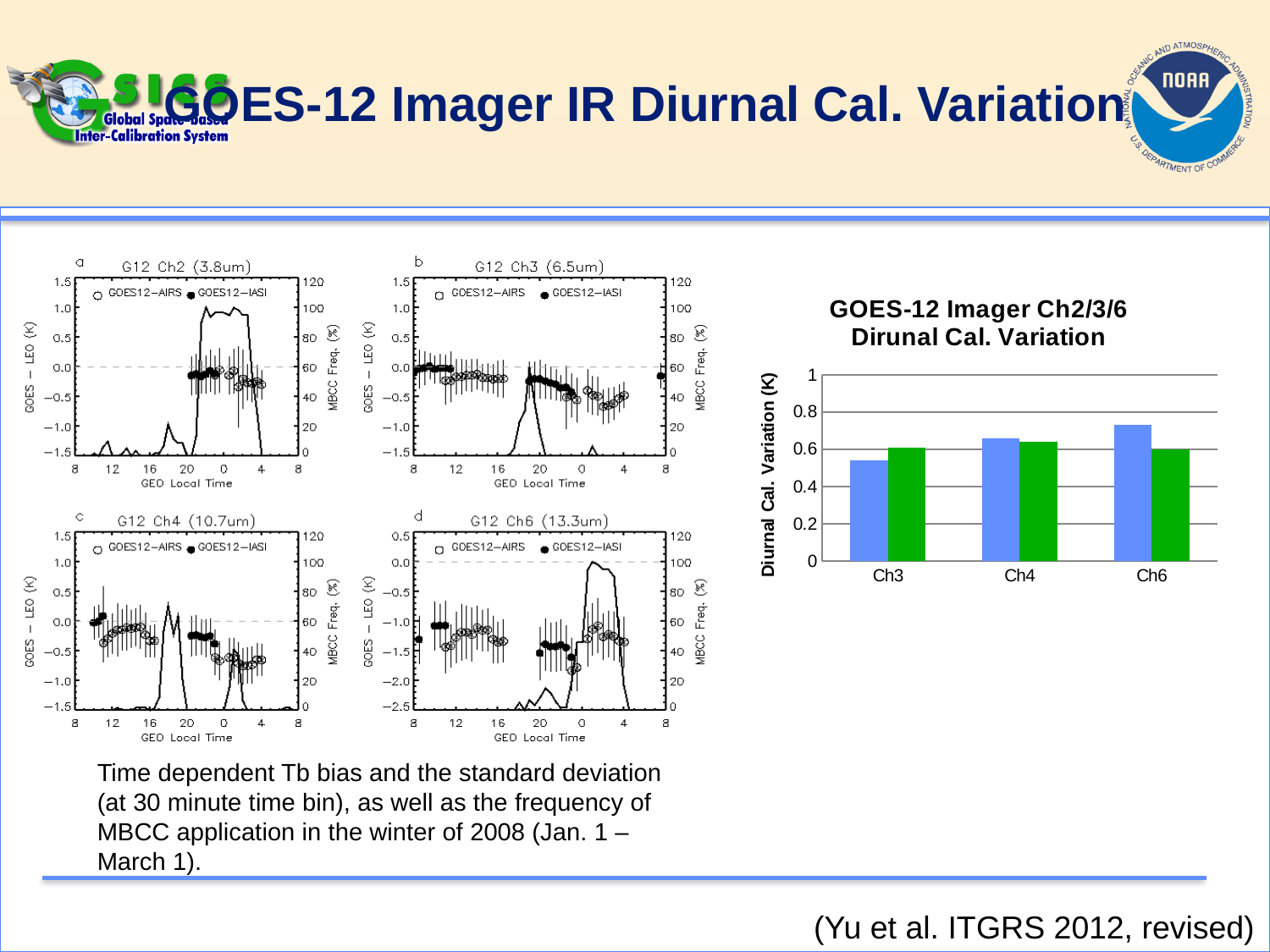
In the bar chart on the right, do the blue bars rise or fall from Ch3 to Ch6? rise In the bar chart on the right, is the blue bar for Ch6 greater or less than 0.6? greater What kind of chart is the 'GOES-12 Imager Ch2/3/6 Dirunal Cal. Variation' chart on the right of the slide? bar chart In the bar chart on the right, for Ch3, is the blue bar or the green bar taller? green In the bar chart on the right, is the blue bar for Ch3 greater or less than 0.6? less In the bar chart on the right, which channel has the tallest blue bar? Ch6 In the four-panel figure on the left, what wavelength is given in the title of the G12 Ch4 panel? 10.7um How many channel categories are shown on the x axis of the bar chart on the right? 3 In the bar chart on the right, for Ch6, is the blue bar or the green bar taller? blue In the bar chart on the right, is the blue bar for Ch6 greater or less than 0.8? less What is the y-axis label of the bar chart on the right? Diurnal Cal. Variation (K) In the bar chart on the right, which channel has the shortest blue bar? Ch3